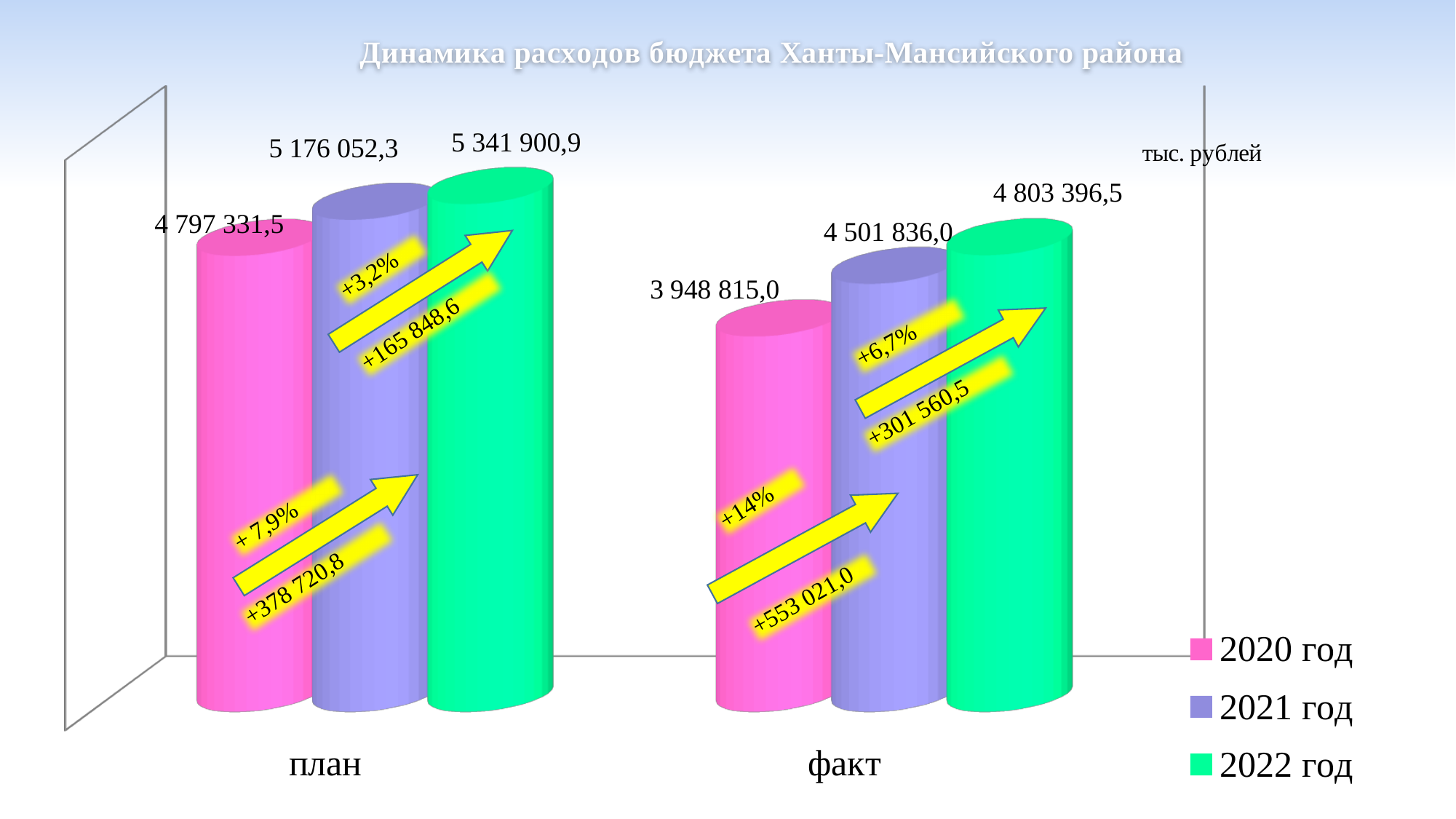
Which year has the highest value in the план category? 2022 год Which is larger: the 2022 год value for план or the 2022 год value for факт? план Which year has the lowest value in the факт category? 2020 год What is the title of the chart? Динамика расходов бюджета Ханты-Мансийского района What is the difference between the 2022 год and 2021 год values in the факт category? 301 560,5 How many categories are shown on the x axis? 2 What is the value for 2021 год in the факт category? 4 501 836,0 How many series does the legend list? 3 What is the difference between the 2021 год and 2020 год values in the план category? 378 720,8 What is the value for 2022 год in the факт category? 4 803 396,5 What kind of chart is shown on the slide? bar chart What is the value for 2020 год in the план category? 4 797 331,5